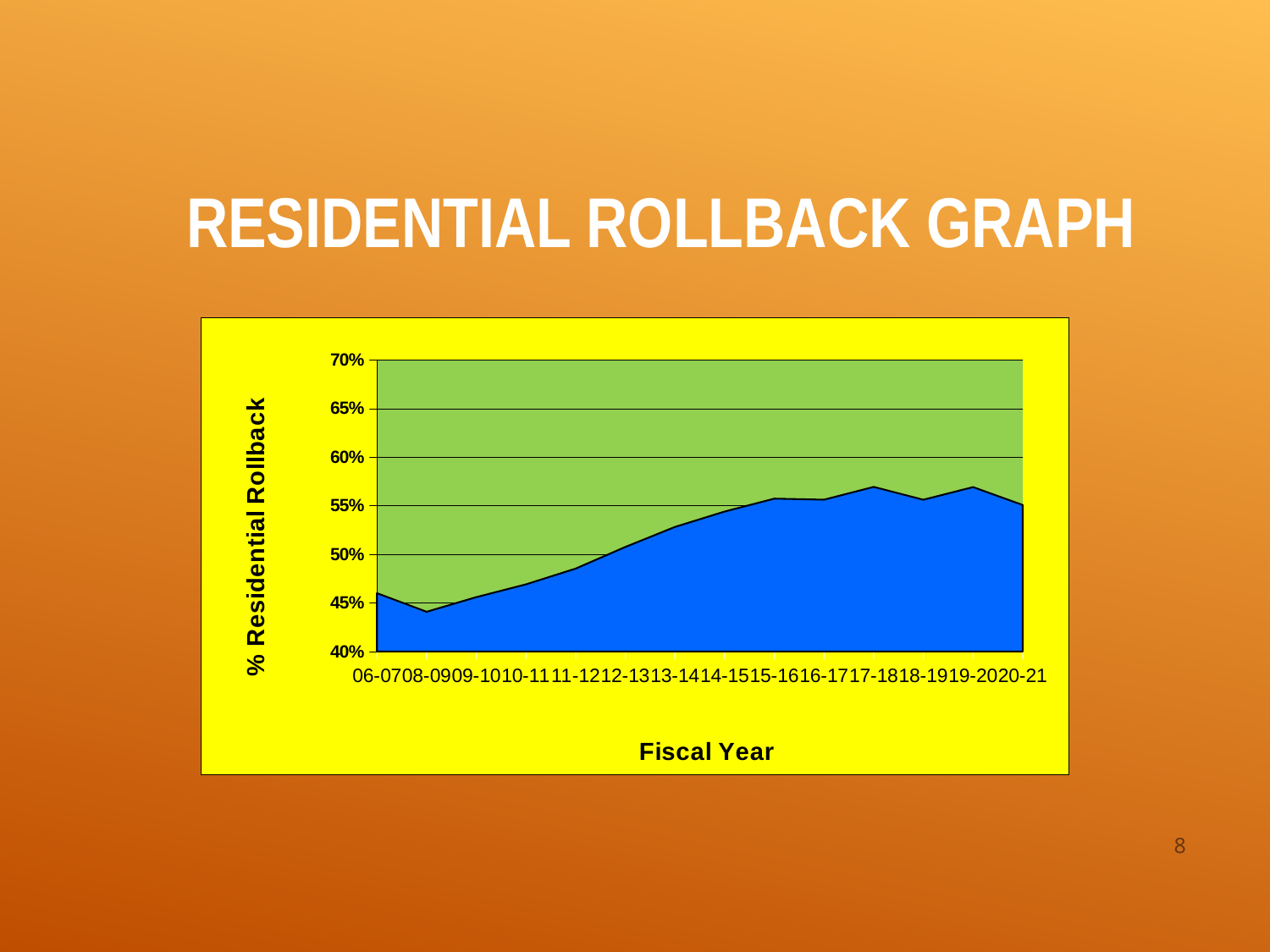
Which has the larger value, fiscal year 08-09 or fiscal year 17-18? 17-18 Is the value for fiscal year 17-18 greater or less than 55%? greater Is the value for fiscal year 13-14 greater or less than 50%? greater What is the label on the vertical axis of the chart? % Residential Rollback Is the value for fiscal year 10-11 greater or less than 50%? less Overall, do the residential rollback values rise or fall from 06-07 to 20-21? rise Which fiscal year has the lowest residential rollback value? 08-09 What kind of chart is shown on the slide? Area chart What is the title of the slide's chart? RESIDENTIAL ROLLBACK GRAPH Which has the larger value, fiscal year 06-07 or fiscal year 20-21? 20-21